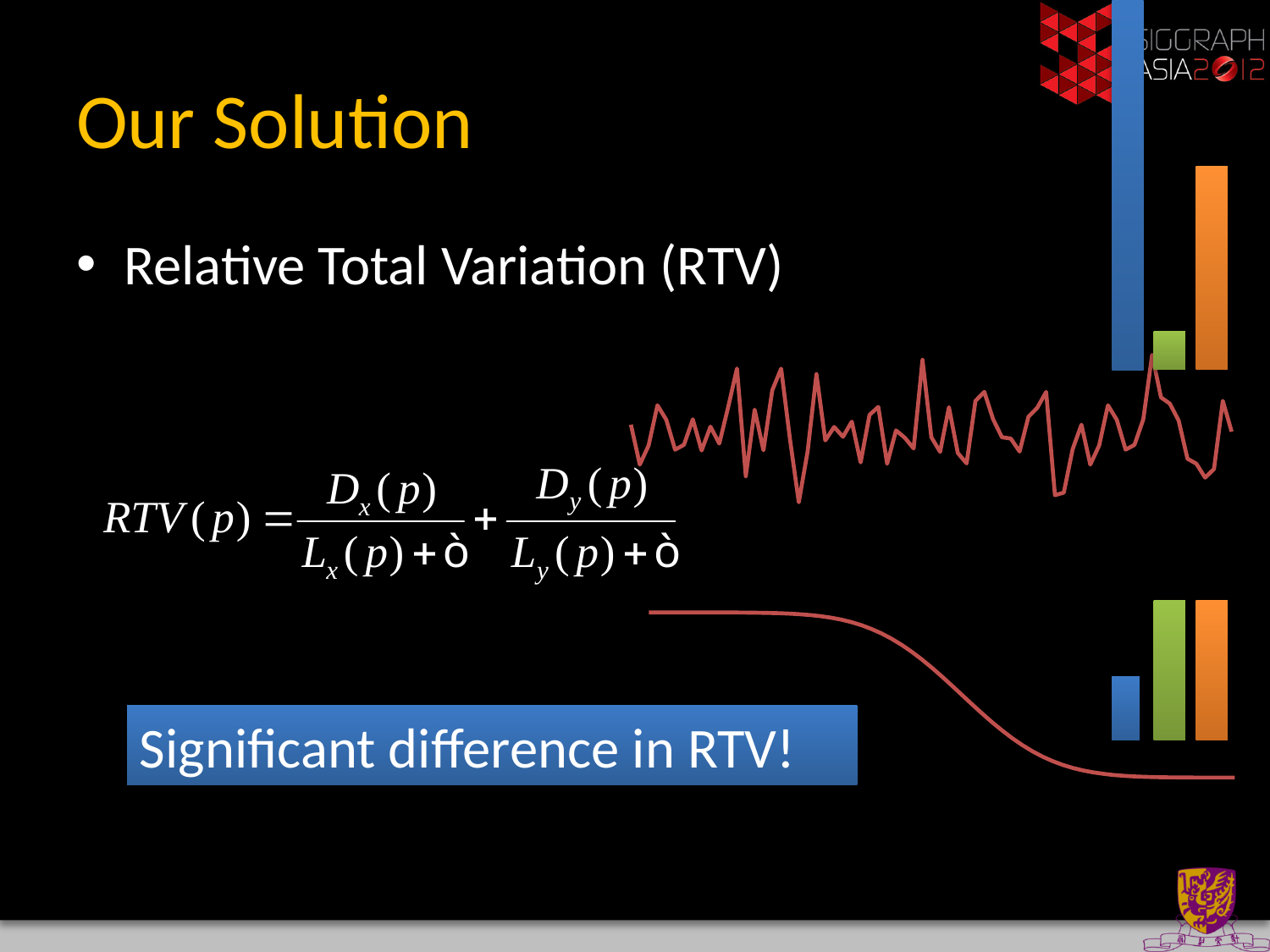
In the top-right bar chart, which is taller, the orange bar or the green bar? orange Do the bar charts on the right of the slide show a legend? No What three colours are used for the bars in the bar charts on the right of the slide? blue, green and orange In the bottom-right bar chart, which coloured bar is the shortest? blue In the top-right bar chart, which coloured bar is the shortest? green What kind of chart is shown at the top right of the slide? bar chart In the bottom-right bar chart, which is taller, the green bar or the blue bar? green In the bottom-right bar chart, which is taller, the orange bar or the blue bar? orange How many bars does the bottom-right bar chart have? 3 What kind of chart is shown at the bottom right of the slide? bar chart How many bars does the top-right bar chart have? 3